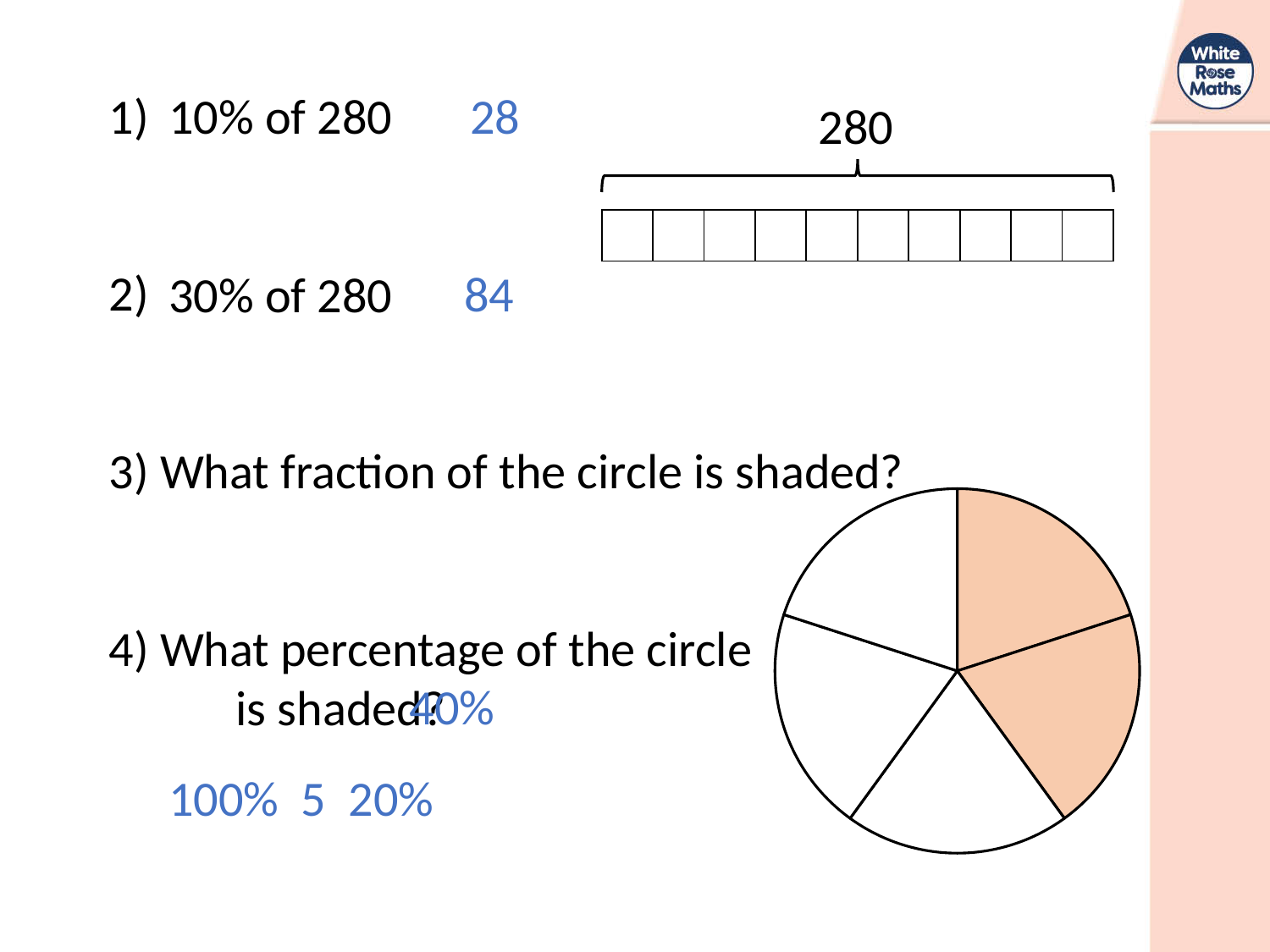
According to the slide, what is 10% of 280? 28 What percentage of the circle does each single section represent, according to the slide? 20% Are more sections of the circle shaded or unshaded? unshaded What percentage of the circle is shaded, according to the answer shown on the slide? 40% What total value is labelled above the bar model at the top right of the slide? 280 How many equal boxes make up the bar model at the top right of the slide? 10 How many equal sections is the circle on the slide divided into? 5 Is the shaded share of the circle greater or less than 50%? less How many sections of the circle are shaded? 2 What colour are the shaded sections of the circle? orange According to the slide, what is 30% of 280? 84